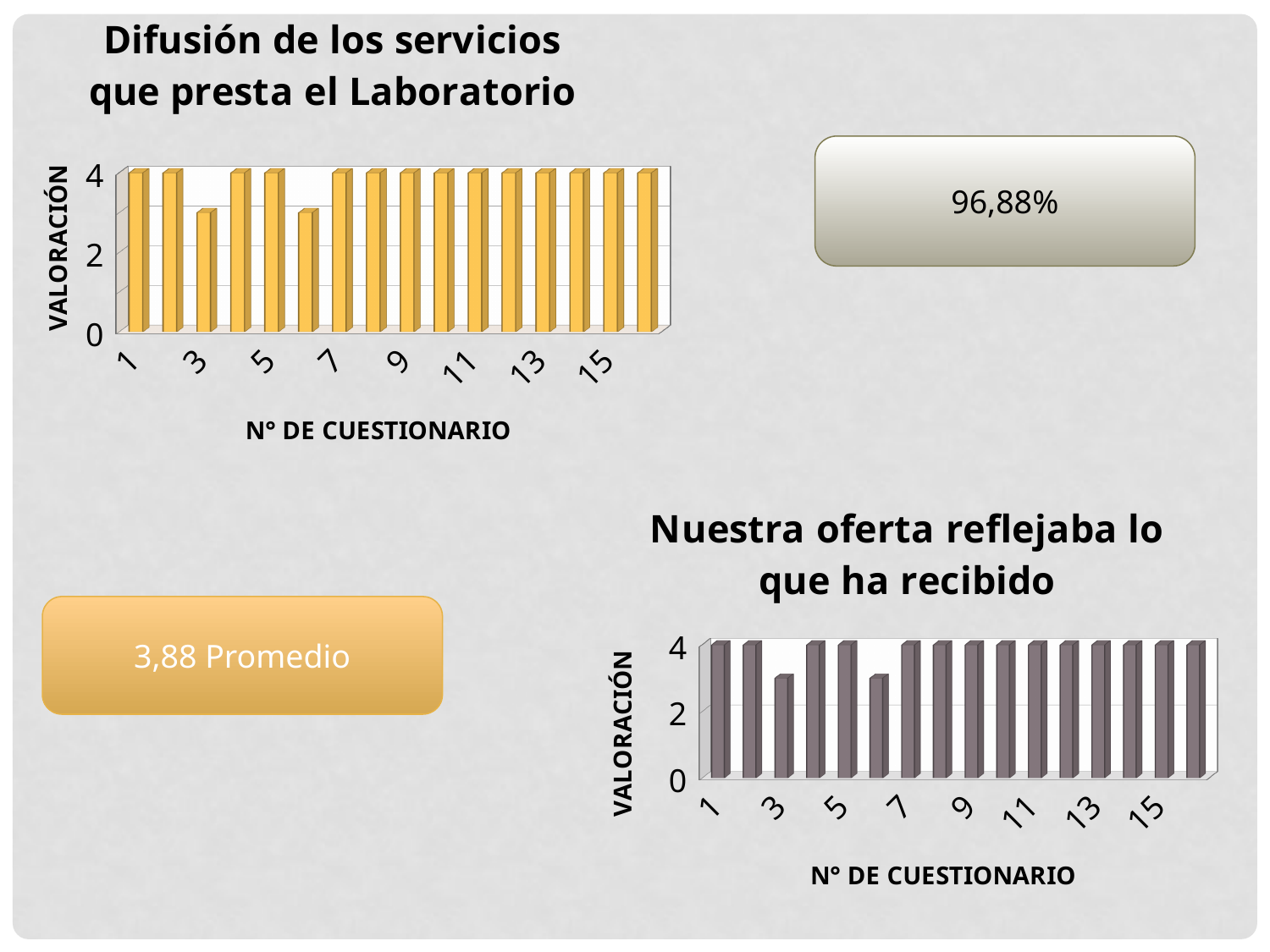
In the chart 'Nuestra oferta reflejaba lo que ha recibido', is the value for questionnaire 6 greater or less than 4? less In the chart 'Difusión de los servicios que presta el Laboratorio', how many questionnaires (bars) are plotted? 16 What type of chart is 'Difusión de los servicios que presta el Laboratorio'? bar chart In the chart 'Difusión de los servicios que presta el Laboratorio', is the value for questionnaire 3 greater or less than 4? less In the chart 'Nuestra oferta reflejaba lo que ha recibido', how many bars are plotted? 16 In the chart 'Nuestra oferta reflejaba lo que ha recibido', which is larger, the value for questionnaire 3 or questionnaire 4? questionnaire 4 What is the x-axis title of the chart 'Nuestra oferta reflejaba lo que ha recibido'? N° DE CUESTIONARIO In the chart 'Difusión de los servicios que presta el Laboratorio', what is the valoración for questionnaire 1? 4 In the chart 'Difusión de los servicios que presta el Laboratorio', which is larger, the value for questionnaire 2 or questionnaire 3? questionnaire 2 In the chart 'Difusión de los servicios que presta el Laboratorio', which questionnaire numbers have the lowest valoración? 3 and 6 In the chart 'Nuestra oferta reflejaba lo que ha recibido', what is the valoración for questionnaire 15? 4 In the chart 'Difusión de los servicios que presta el Laboratorio', is the value for questionnaire 6 greater or less than 2? greater